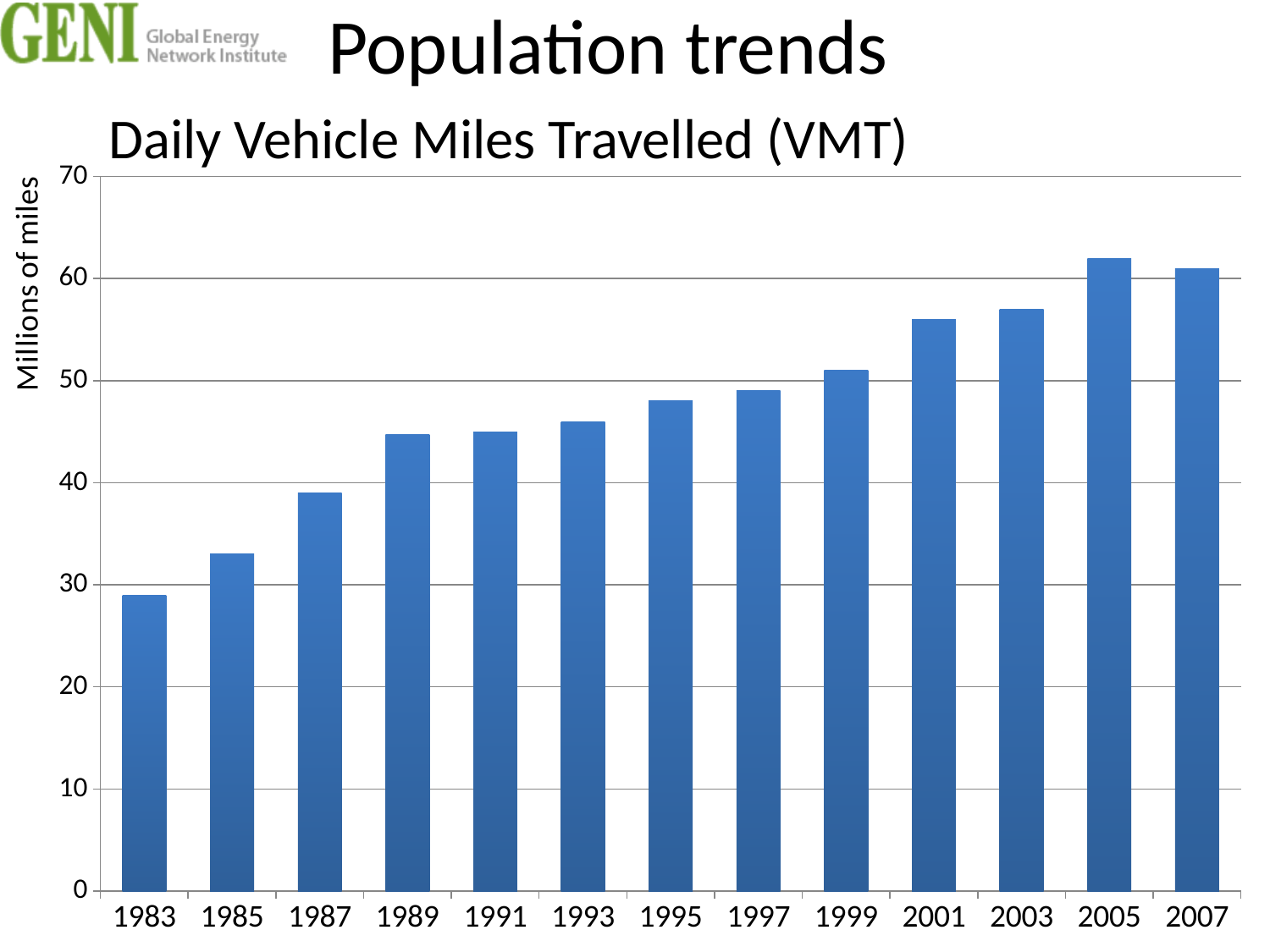
Is the value for 2005 greater or less than 60? greater What is the label on the vertical axis of the chart? Millions of miles Which year has the lowest daily vehicle miles travelled? 1983 Is the value for 2001 greater or less than 50? greater Is the value for 1983 greater or less than 20? greater Do the values generally rise or fall from 1983 to 2007? rise How many years are plotted on the x axis of the chart? 13 Which is larger, the value for 1999 or the value for 2001? 2001 What kind of chart is shown on the slide? bar chart